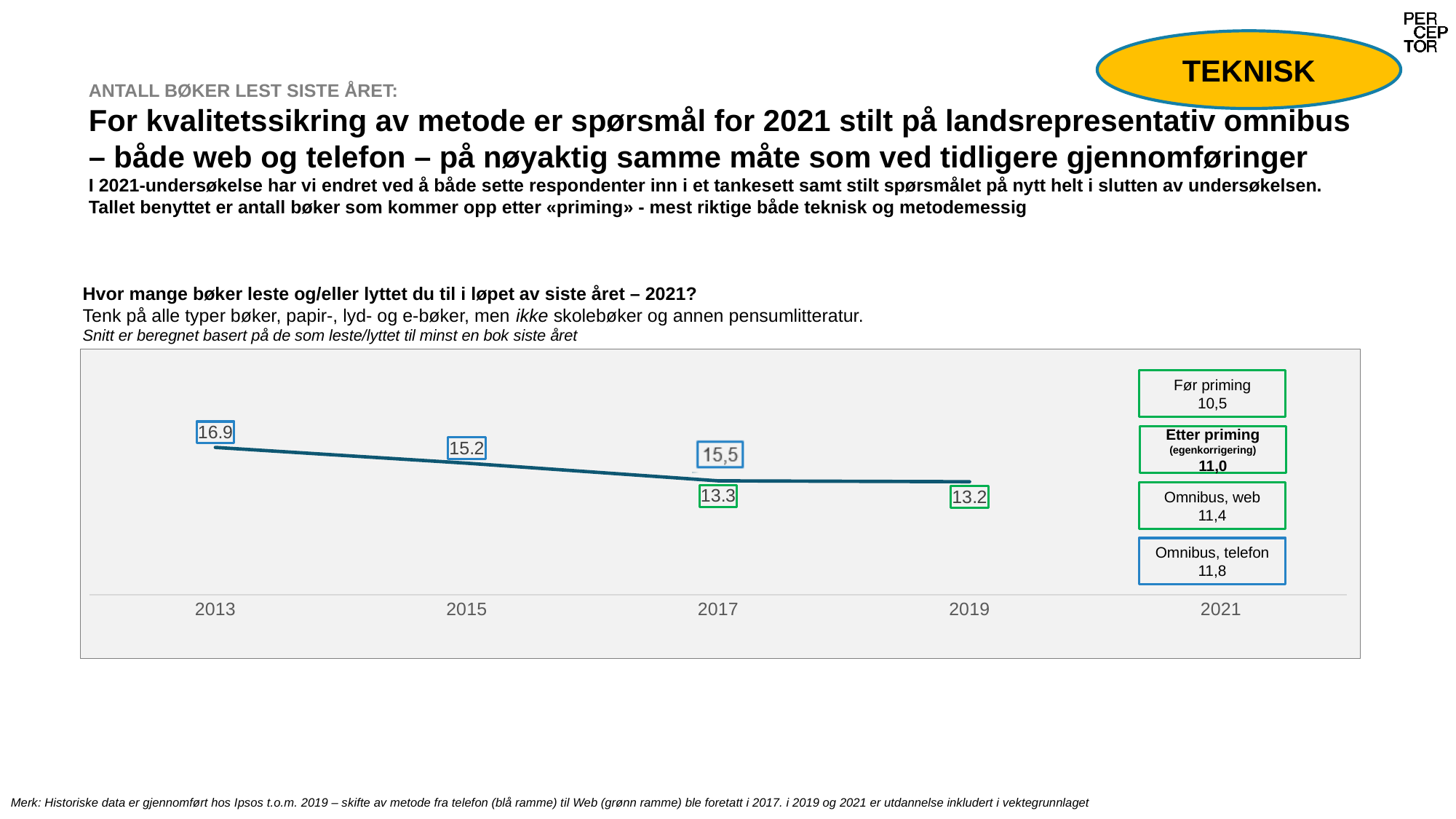
What is the value labelled 'Omnibus, telefon' for 2021? 11,8 What value is shown for 2019 in the chart? 13.2 What kind of chart is shown on the slide? line chart What value is shown for 2013 in the chart? 16.9 What is the value labelled 'Før priming' for 2021? 10,5 Which is larger, the value for 2013 or the value for 2019? 2013 What is the green-framed value shown for 2017? 13.3 What is the value labelled 'Omnibus, web' for 2021? 11,4 What is the difference between the 2013 value (16.9) and the 2015 value (15.2)? 1.7 What value is shown for 2015 in the chart? 15.2 What is the blue-framed value shown for 2017? 15,5 Does the plotted line rise or fall from 2013 to 2019? fall